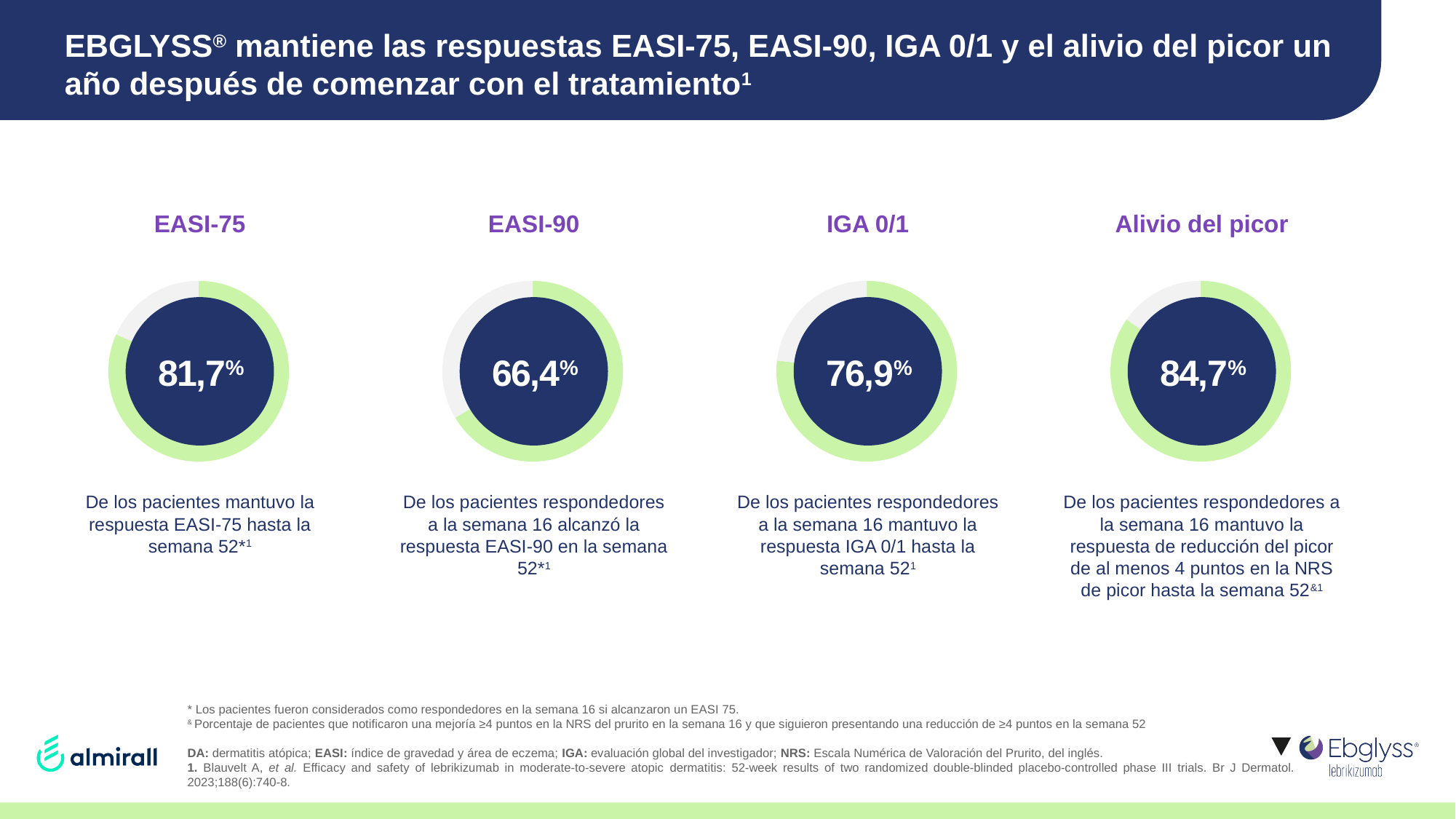
Across the four charts on the slide, which one shows the lowest percentage? EASI-90 Which is larger, the value in the IGA 0/1 chart or the value in the EASI-90 chart? IGA 0/1 What is the difference between the value in the EASI-75 chart and the value in the EASI-90 chart? 15,3% What value is shown in the IGA 0/1 chart? 76,9% What is the difference between the value in the Alivio del picor chart and the value in the IGA 0/1 chart? 7,8% What value is shown in the Alivio del picor chart? 84,7% Across the four charts on the slide, which one shows the highest percentage? Alivio del picor What colour is the filled portion of the ring in the Alivio del picor chart? Green What kind of chart is used to show the EASI-75 value? Donut (ring) chart How many ring charts are shown on the slide? 4 What value is shown in the EASI-90 chart? 66,4% What value is shown in the EASI-75 chart? 81,7%